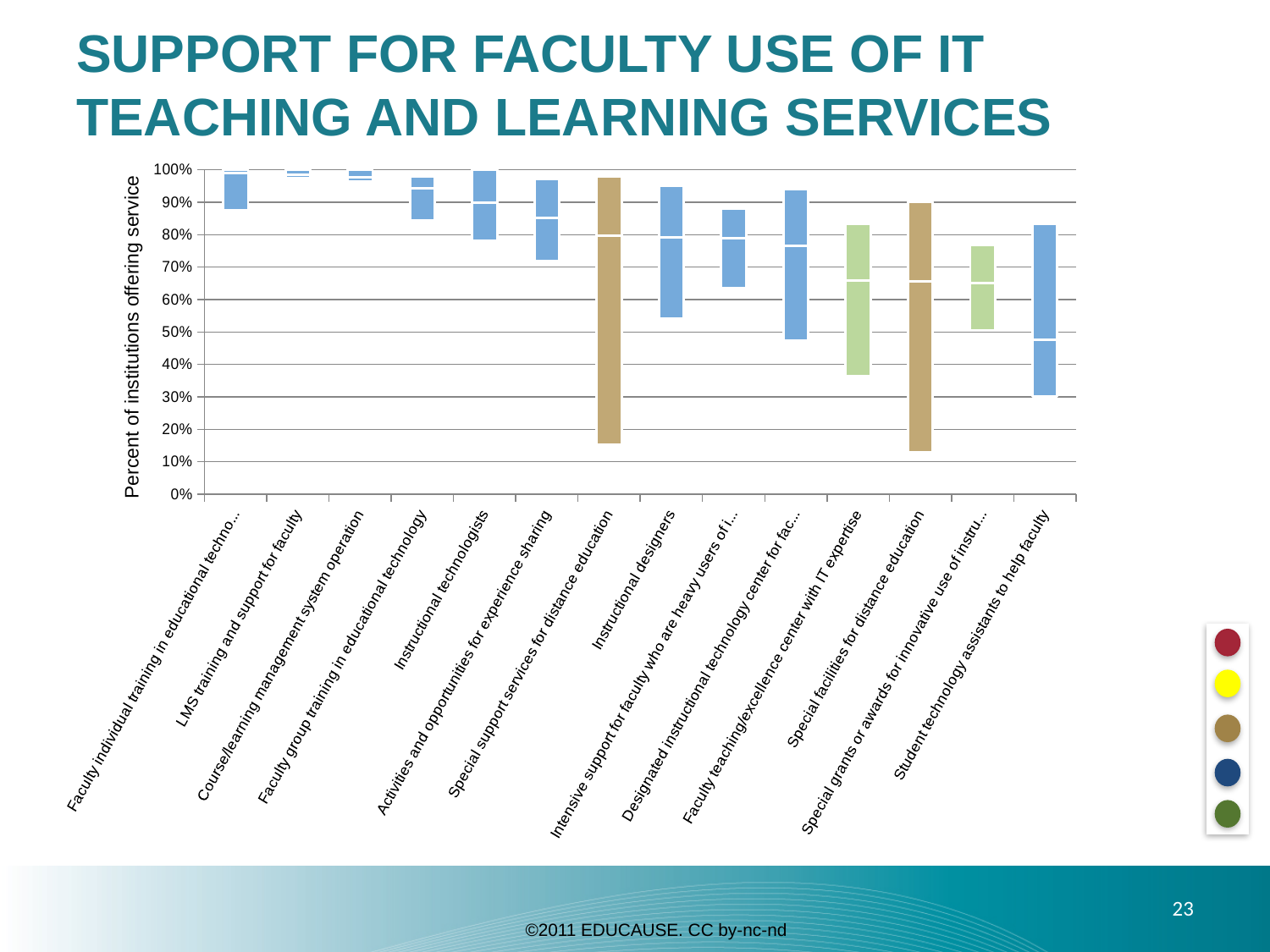
Moving from left to right along the x axis, do the tops of the bars generally rise or fall? fall What kind of chart is shown on the slide? bar chart Is the top of the bar for 'Special facilities for distance education' greater or less than 80%? greater What is the title of the y axis of the chart? Percent of institutions offering service How many categories are shown along the x axis of the chart? 14 Is the bottom of the bar for 'Special support services for distance education' greater or less than 20%? less Is the top of the bar for 'Instructional designers' greater or less than 90%? greater How many bars in the chart are coloured tan/brown rather than blue or green? 2